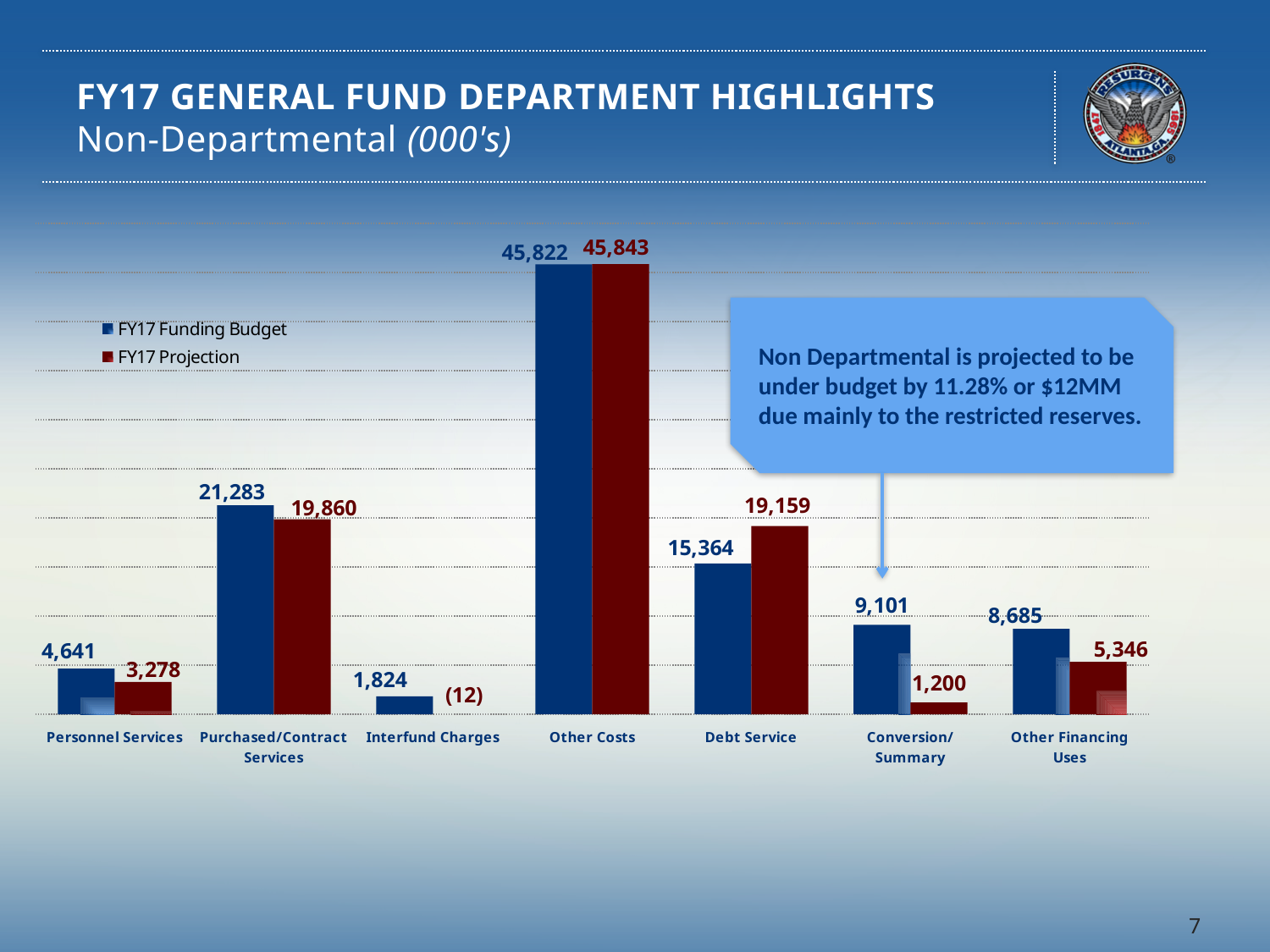
For Debt Service, which is larger: the FY17 Funding Budget or the FY17 Projection? FY17 Projection What is the FY17 Funding Budget value for Conversion/Summary? 9,101 What kind of chart is shown on the slide? Bar chart Which category has the highest FY17 Funding Budget value? Other Costs What is the FY17 Projection value for Debt Service? 19,159 How many categories are shown on the x axis of the chart? 7 Which category has the lowest FY17 Projection value? Interfund Charges How many series does the legend list? 2 What colour represents the FY17 Projection series in the chart? Dark red What is the difference between the FY17 Funding Budget and FY17 Projection for Purchased/Contract Services? 1,423 What is the FY17 Projection value for Interfund Charges? (12) What is the FY17 Funding Budget value for Personnel Services? 4,641